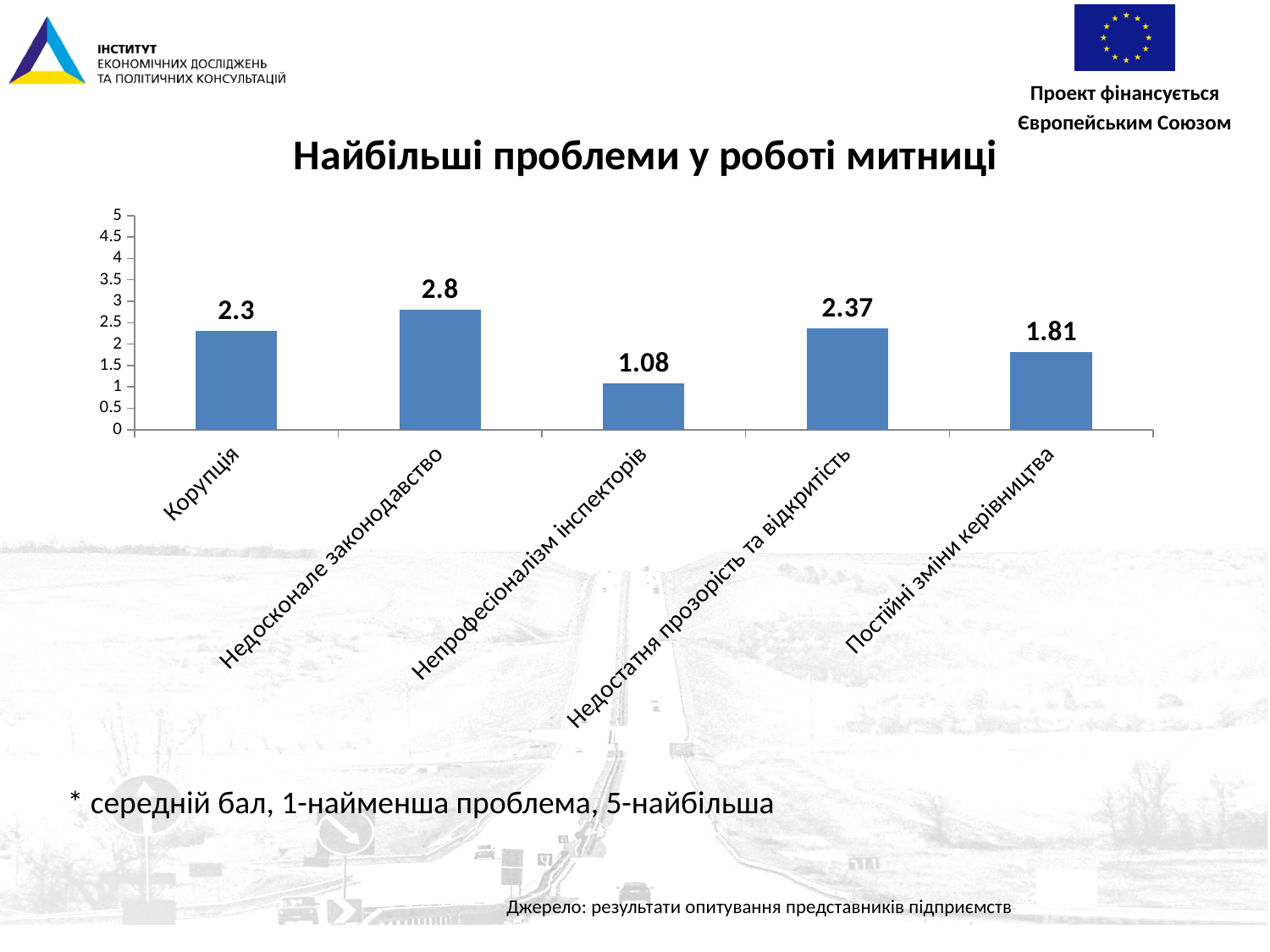
Which category has the highest value? Недосконале законодавство What is the value for Корупція? 2.3 What is the value for Постійні зміни керівництва? 1.81 What kind of chart is shown on the slide? Bar chart What is the value for Непрофесіоналізм інспекторів? 1.08 What is the value for Недосконале законодавство? 2.8 What is the title of the chart? Найбільші проблеми у роботі митниці Which is larger, the value for Недостатня прозорість та відкритість or the value for Постійні зміни керівництва? Недостатня прозорість та відкритість How many categories are shown in the chart? 5 What is the value for Недостатня прозорість та відкритість? 2.37 Which category has the lowest value? Непрофесіоналізм інспекторів What is the difference between the values for Недосконале законодавство and Корупція? 0.5